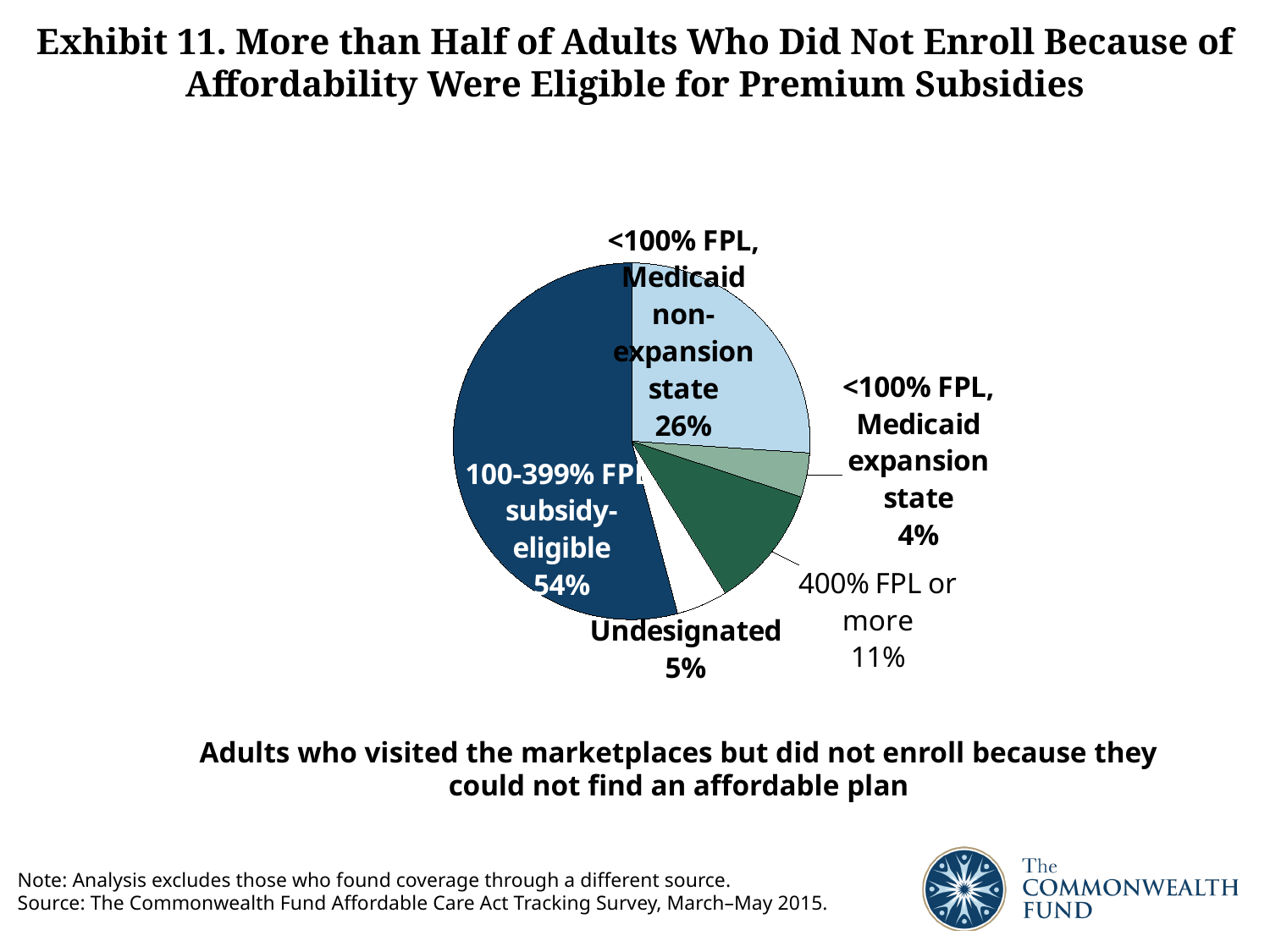
What is the value for '<100% FPL, Medicaid expansion state'? 4% Which is larger: the '400% FPL or more' slice or the 'Undesignated' slice? 400% FPL or more What share of the pie is 'Undesignated'? 5% Which category has the largest slice of the pie? 100-399% FPL subsidy-eligible What share of adults who did not enroll because of affordability were 100-399% FPL subsidy-eligible? 54% What is the difference in percentage points between the '100-399% FPL subsidy-eligible' slice and the '<100% FPL, Medicaid non-expansion state' slice? 28 percentage points Which category has the smallest slice of the pie? <100% FPL, Medicaid expansion state What type of chart is shown on the slide? Pie chart What percentage of the pie is labeled '<100% FPL, Medicaid non-expansion state'? 26% What is the exhibit number of this chart? Exhibit 11 How many slices does the pie chart have? 5 What percentage of adults were at 400% FPL or more? 11%